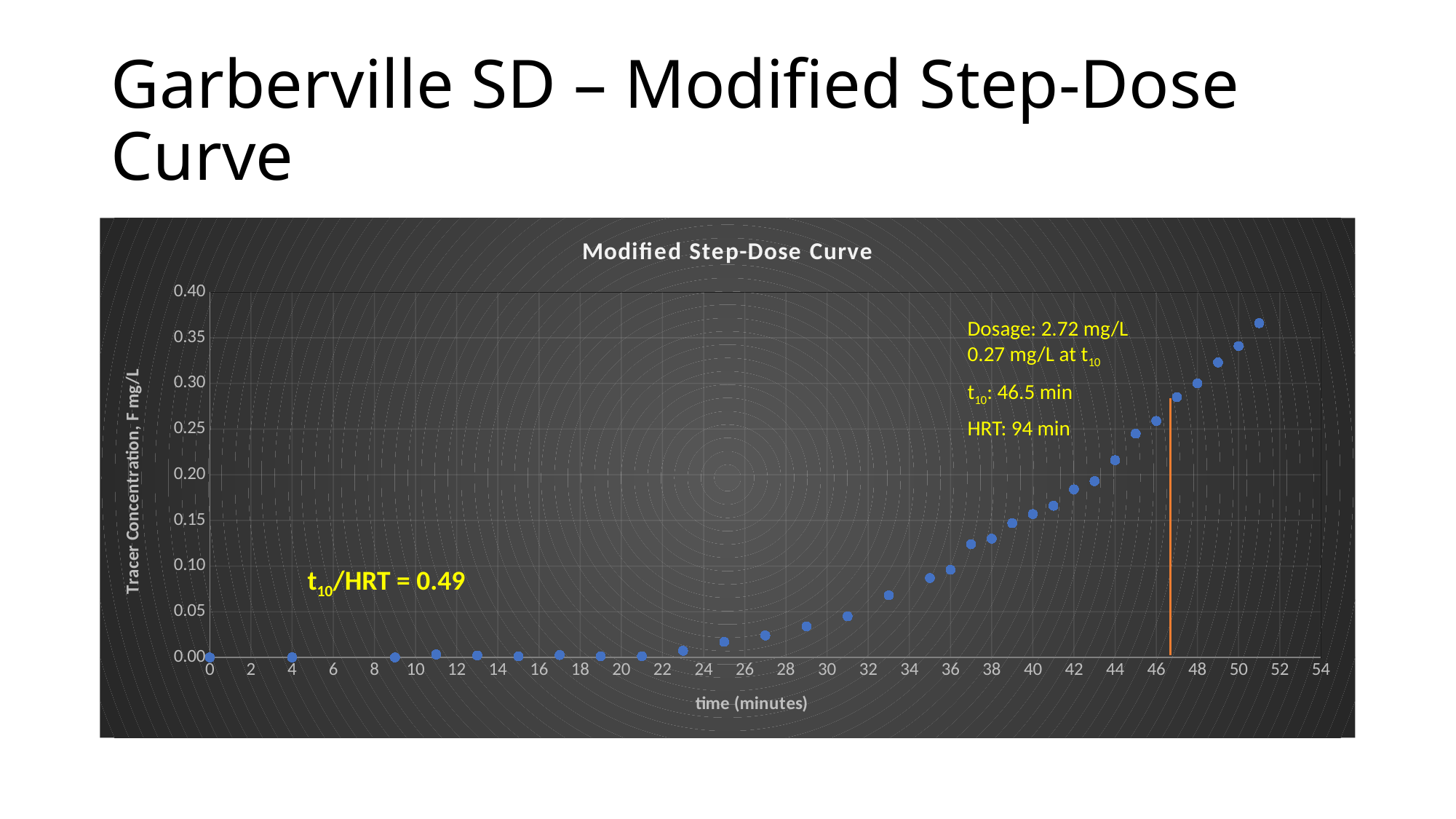
Is the tracer concentration at 50 minutes greater or less than 0.30? greater Which has the higher tracer concentration, the point at 20 minutes or the point at 46 minutes? 46 minutes Is the tracer concentration at 30 minutes greater or less than 0.10? less What is the t10/HRT ratio shown on the chart? 0.49 What dosage is annotated on the chart? 2.72 mg/L Is the tracer concentration at 44 minutes greater or less than 0.15? greater What is the label of the x axis? time (minutes) What HRT value is annotated on the chart? 94 min What t10 value is annotated on the chart? 46.5 min Do the tracer concentration values rise or fall as time increases along the x axis? rise What kind of chart is the Modified Step-Dose Curve? scatter chart